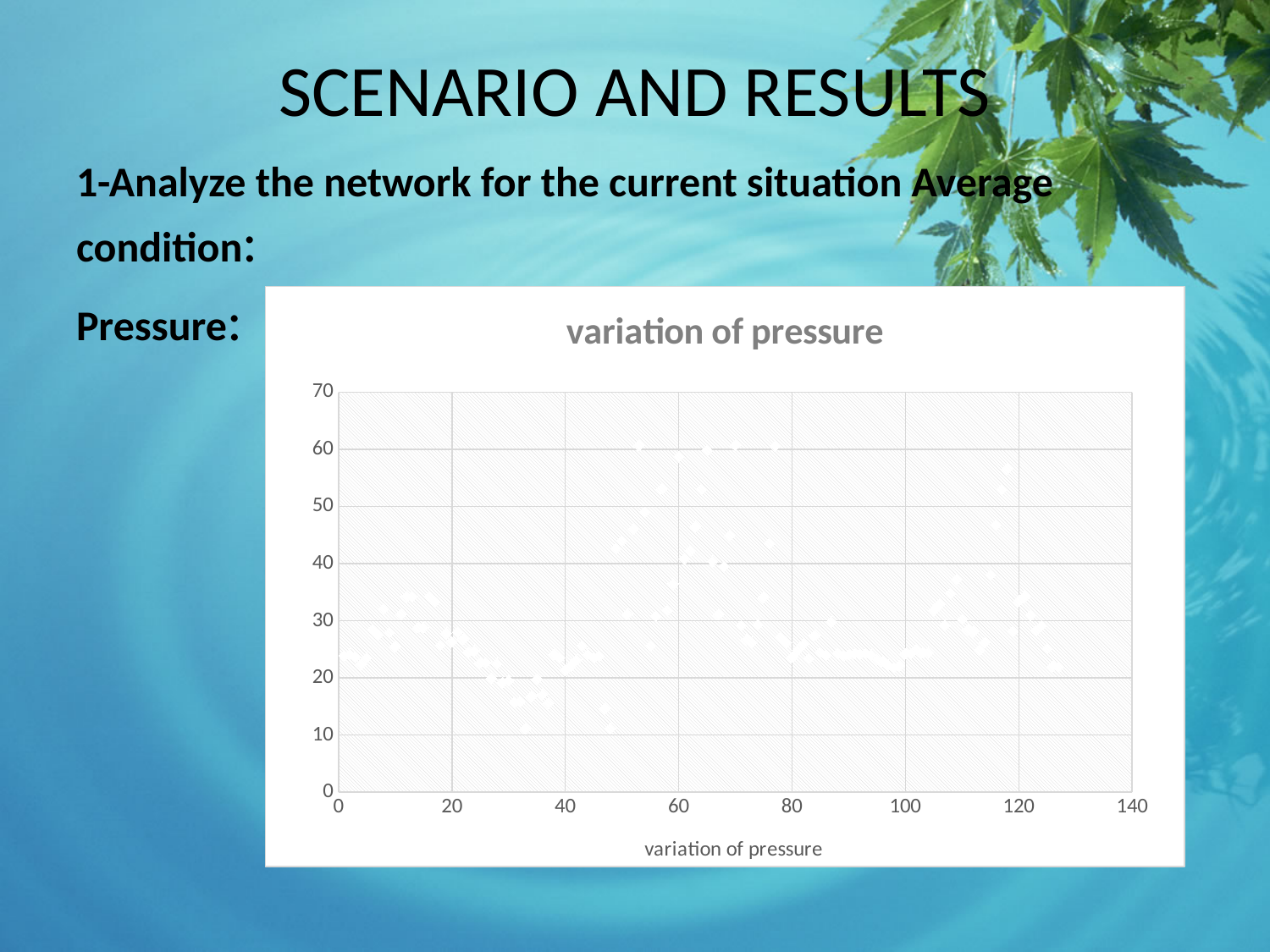
What is the name of the series shown in the chart legend? variation of pressure What kind of chart is shown on the slide? scatter chart How many series does the chart legend list? 1 What is the title of the chart? variation of pressure What is the highest value shown on the x axis of the chart? 140 What is the highest value shown on the y axis of the chart? 70